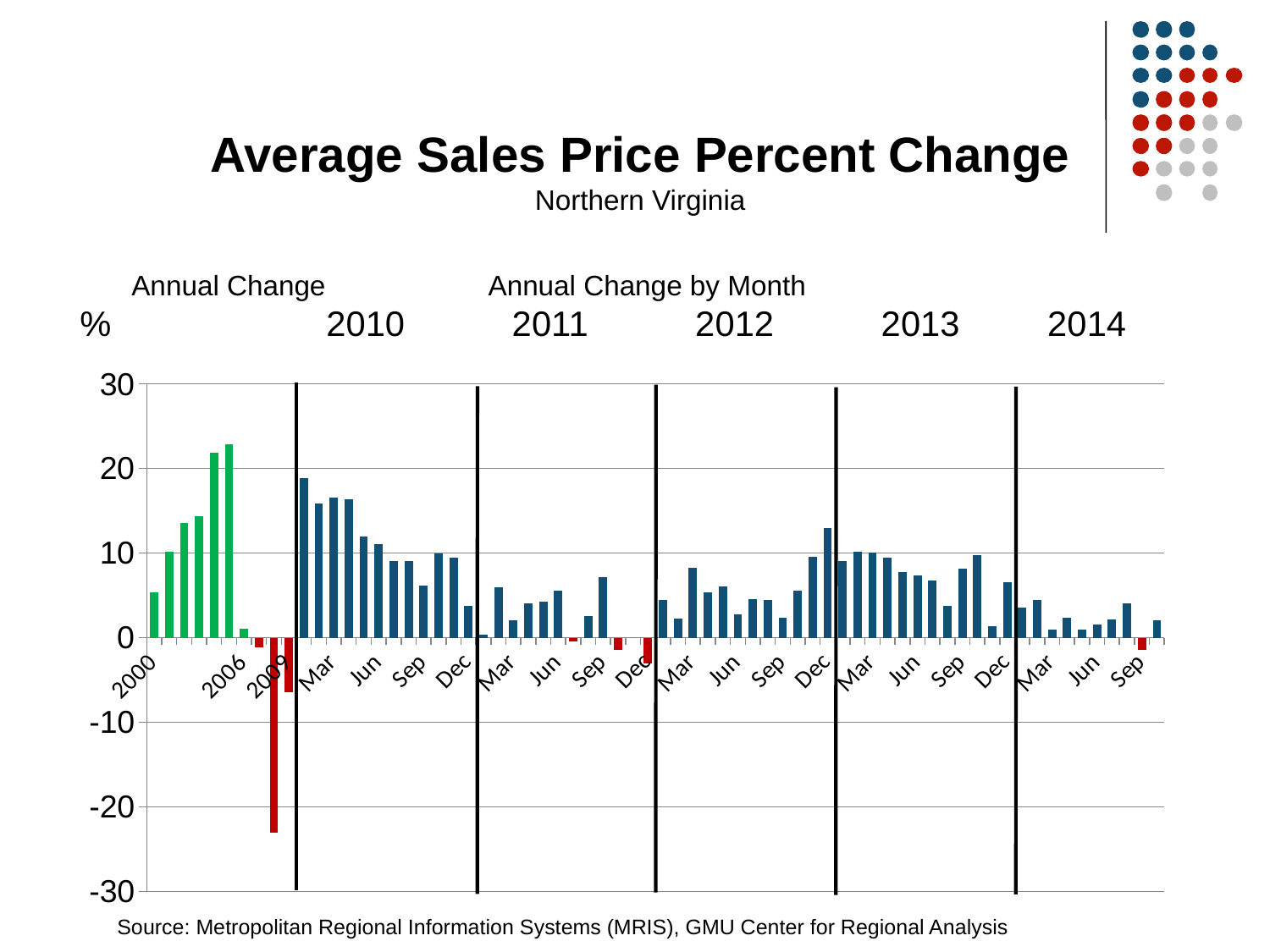
Is the annual change value for 2000 greater or less than 10? less Is the value for the first month of 2010 greater or less than 20? less Which year has the lowest annual change bar in the Annual Change section? 2008 How many years are shown in the Annual Change by Month section? 5 Is the annual change value for 2006 greater or less than 20? less Do the monthly values during 2010 generally rise or fall from Jan to Dec? fall What is the title of the chart? Average Sales Price Percent Change Which year has the highest bar in the Annual Change section? 2005 What kind of chart is shown on the slide? bar chart Which region does the chart cover, according to the subtitle? Northern Virginia